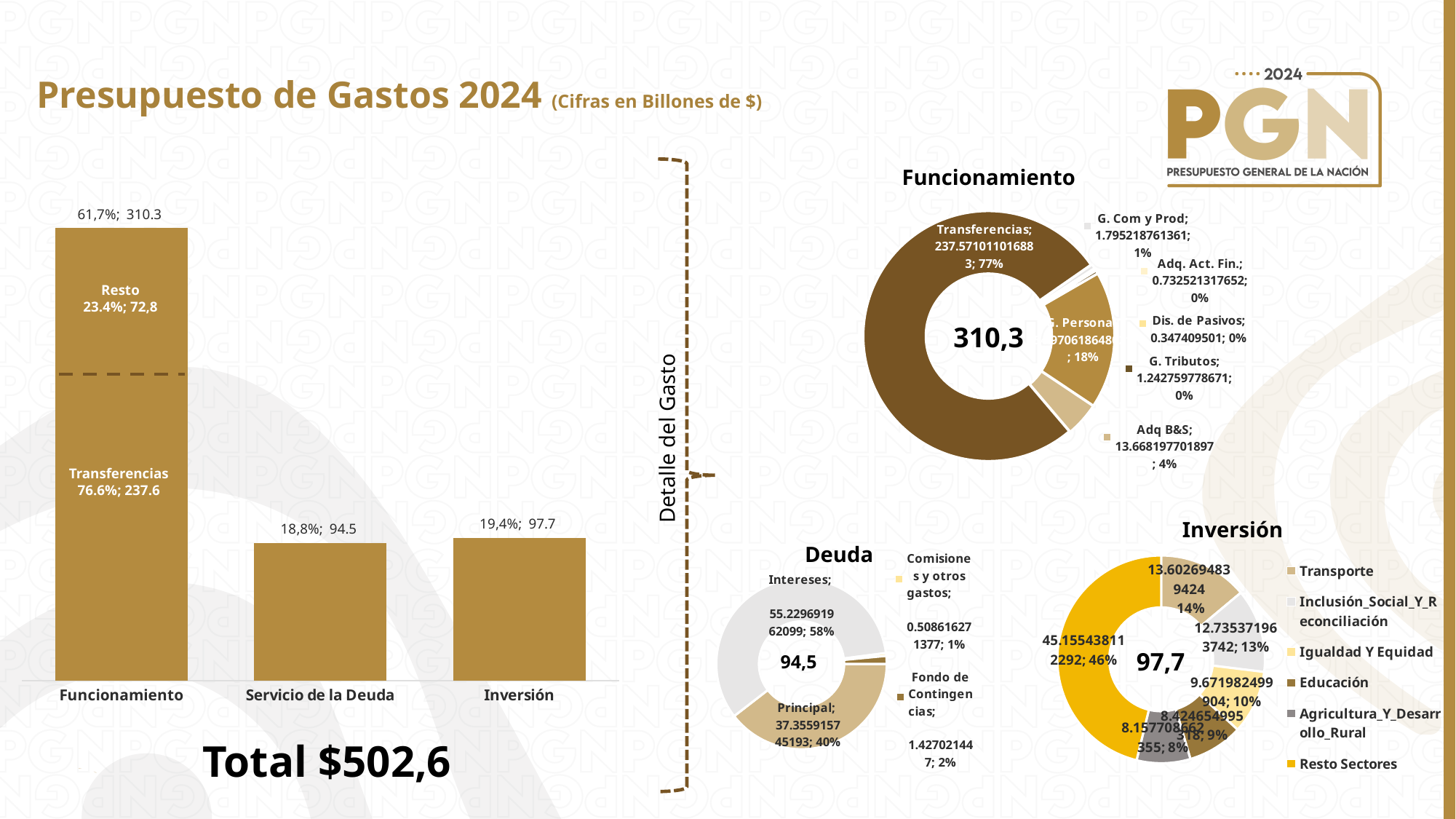
In the bar chart on the left, what is the difference between the values for Inversión and Servicio de la Deuda? 3.2 In the bar chart on the left, what percentage is shown for Servicio de la Deuda? 18,8% In the Deuda donut chart, what share does Principal have? 40% In the bar chart on the left, what value is shown for the Transferencias portion of the Funcionamiento bar? 237.6 How many entries does the legend of the Inversión donut chart list? 6 In the bar chart on the left, how many categories are shown on the x axis? 3 In the bar chart on the left, which category has the lowest value? Servicio de la Deuda In the bar chart on the left, what value is shown for Funcionamiento? 310.3 What kind of chart is the Funcionamiento chart on the right? Donut chart In the Inversión donut chart, which slice has the largest share? Resto Sectores In the bar chart on the left, which category has the highest value? Funcionamiento In the Funcionamiento donut chart, what share does Transferencias have? 77%